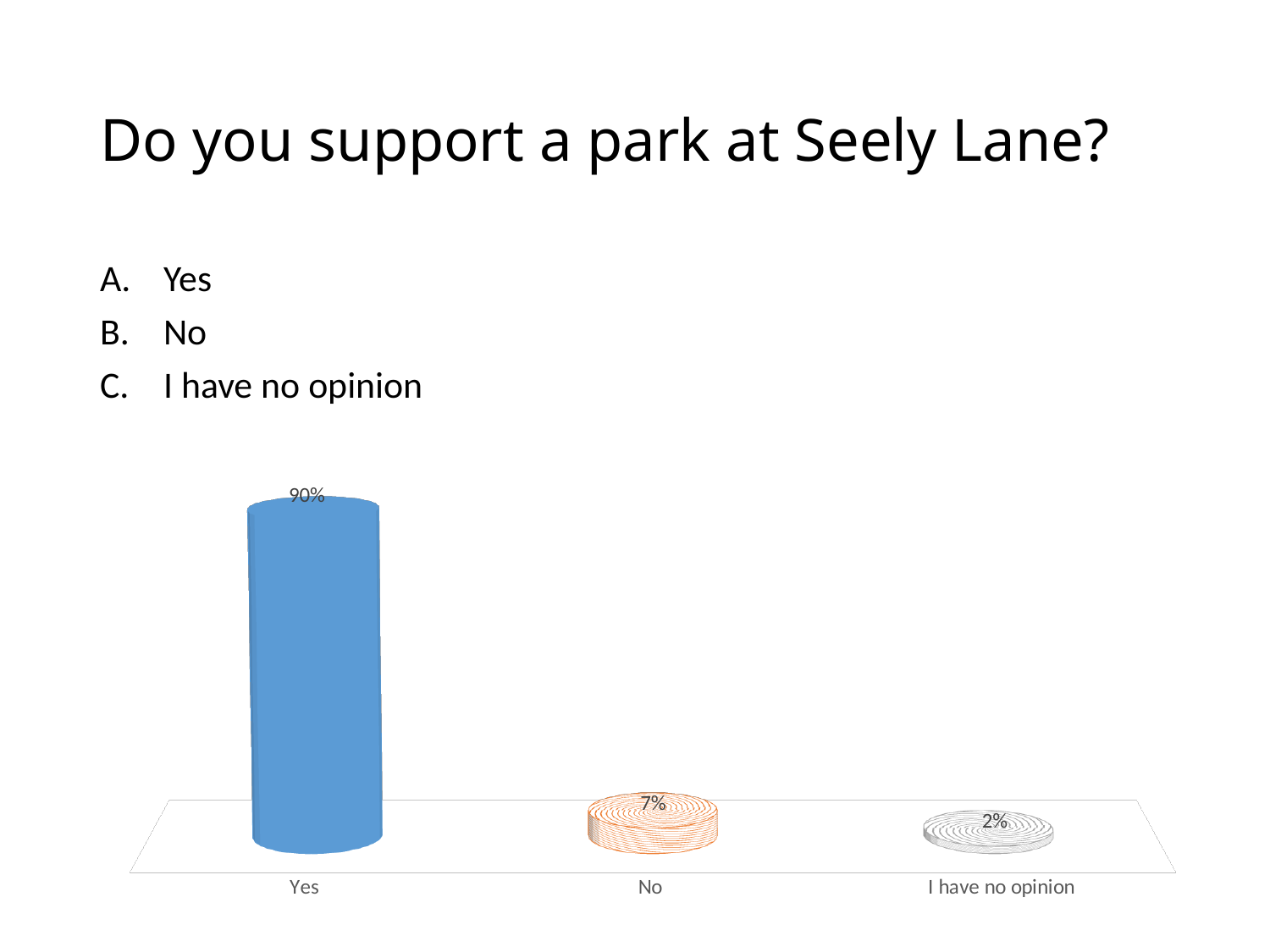
How many response categories are shown on the chart? 3 What is the difference in percentage points between "No" and "I have no opinion"? 5 What percentage of respondents answered "Yes"? 90% What kind of chart is shown on the slide? Bar chart Which response received the highest percentage? Yes What percentage of respondents answered "I have no opinion"? 2% Do the values rise or fall from left to right across the categories? Fall What colour is the bar for "Yes"? Blue Which response has a larger percentage, "No" or "I have no opinion"? No Which response received the lowest percentage? I have no opinion What is the difference in percentage points between "Yes" and "No"? 83 What percentage of respondents answered "No"? 7%